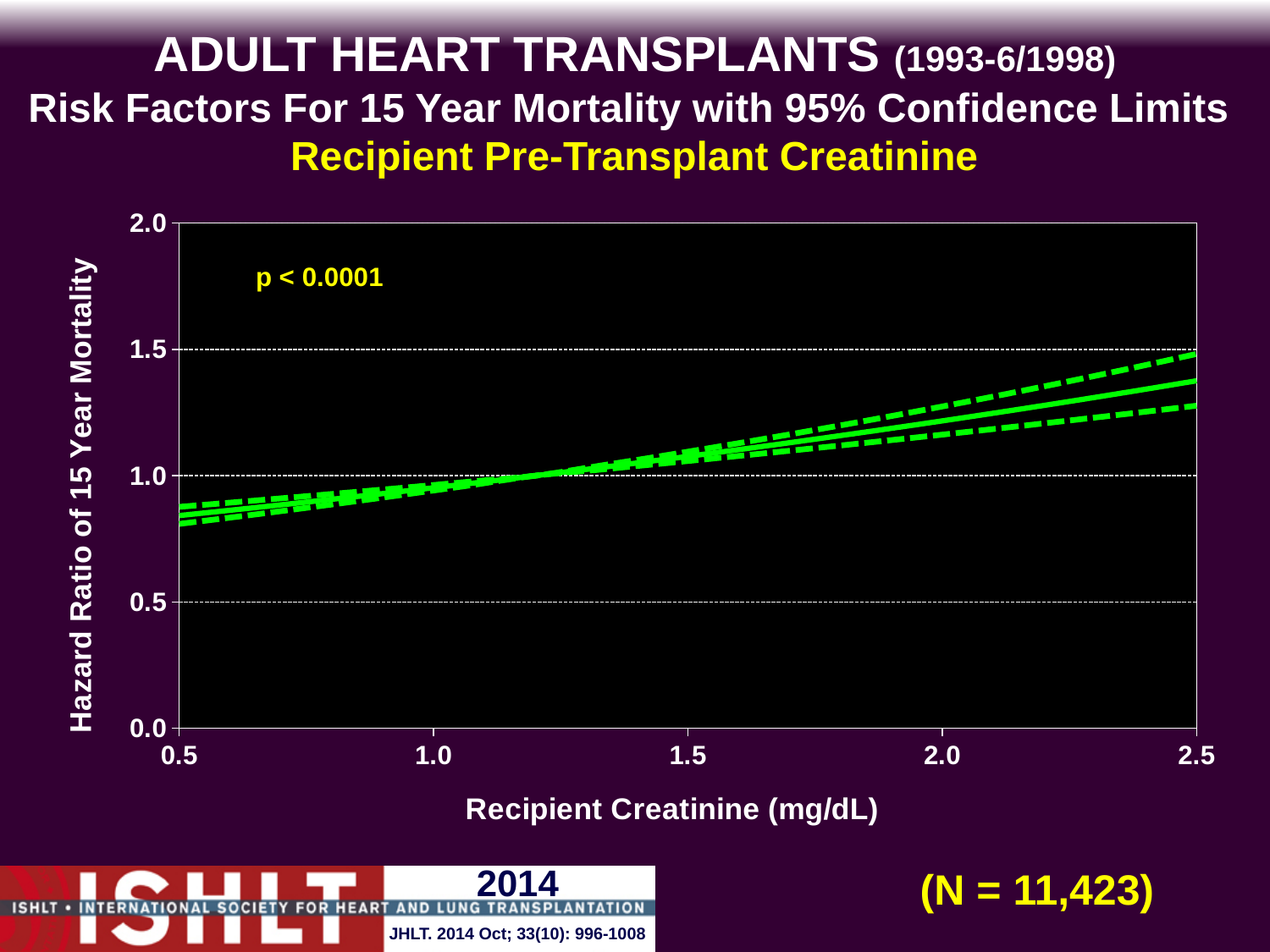
What is the highest value shown on the y axis? 2.0 Which has the higher hazard ratio: a recipient creatinine of 1.0 mg/dL or 2.0 mg/dL? 2.0 mg/dL How many lines are plotted on the chart (the estimate plus its confidence limits)? 3 Is the hazard ratio for a recipient creatinine of 2.0 mg/dL greater or less than 1.0? greater What kind of chart is shown on the slide? line chart Is the hazard ratio for a recipient creatinine of 0.5 mg/dL greater or less than 1.0? less Is the hazard ratio for a recipient creatinine of 2.5 mg/dL greater or less than 1.0? greater Does the hazard ratio of 15 year mortality rise or fall as recipient creatinine increases from 0.5 to 2.5 mg/dL? rise What p-value is printed on the chart? p < 0.0001 What is the label of the x axis? Recipient Creatinine (mg/dL)